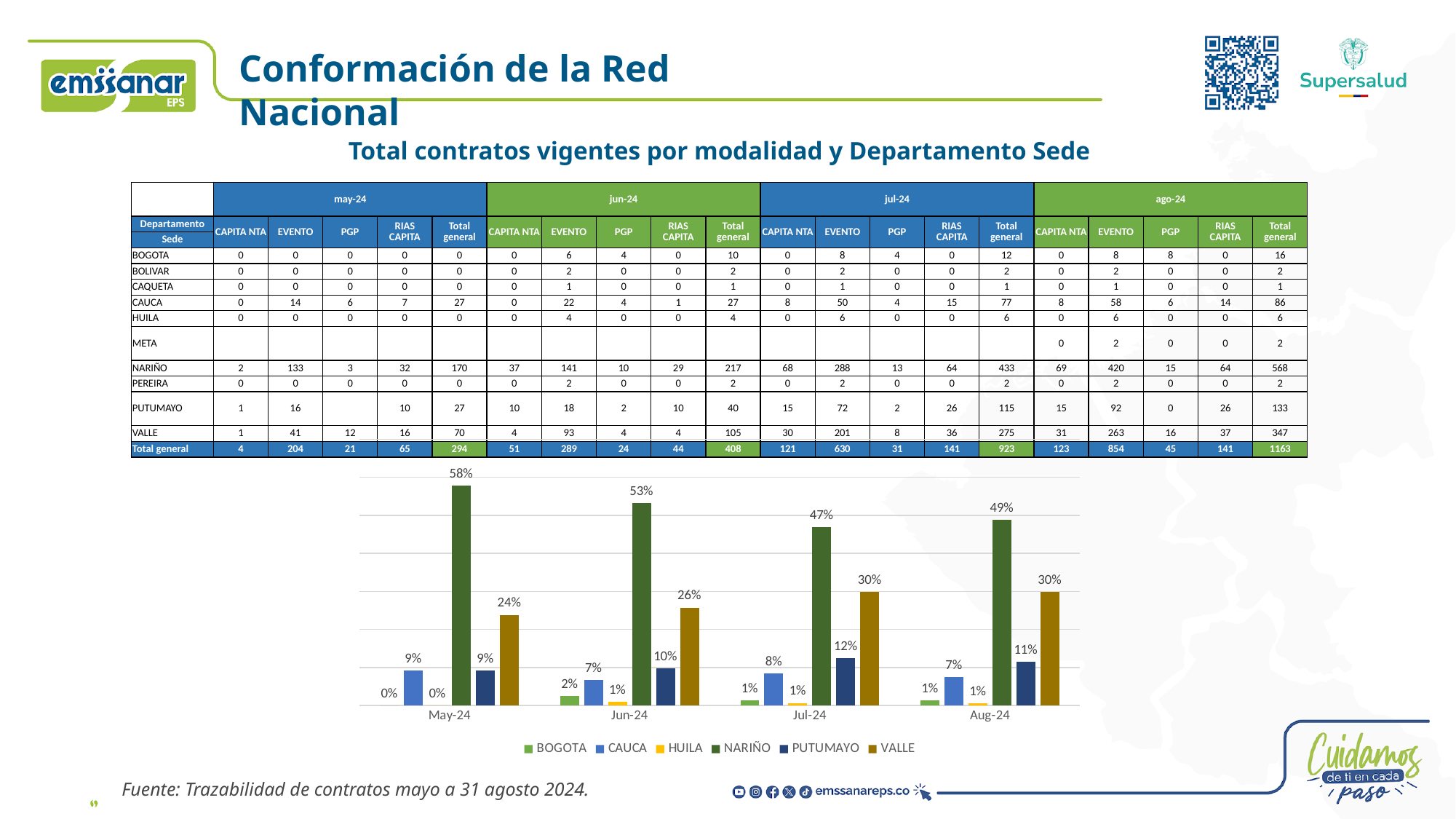
What is the difference between the NARIÑO value in May-24 and in Jun-24 in the chart? 5% How many series does the chart legend list? 6 Does the NARIÑO value in the chart rise or fall from May-24 to Jul-24? fall How many month categories are shown on the x axis of the chart? 4 Which series has the highest value in Aug-24 in the chart? NARIÑO What is the value for PUTUMAYO in Jul-24 in the chart? 12% What type of chart is shown below the table on the slide? bar chart Which colour represents VALLE in the chart legend? dark yellow/olive Which series has the lowest value in Jun-24 in the chart? HUILA In the chart, is the value for CAUCA in May-24 larger or smaller than the value for CAUCA in Jun-24? larger What is the value for NARIÑO in May-24 in the chart? 58% What is the value for VALLE in Jun-24 in the chart? 26%